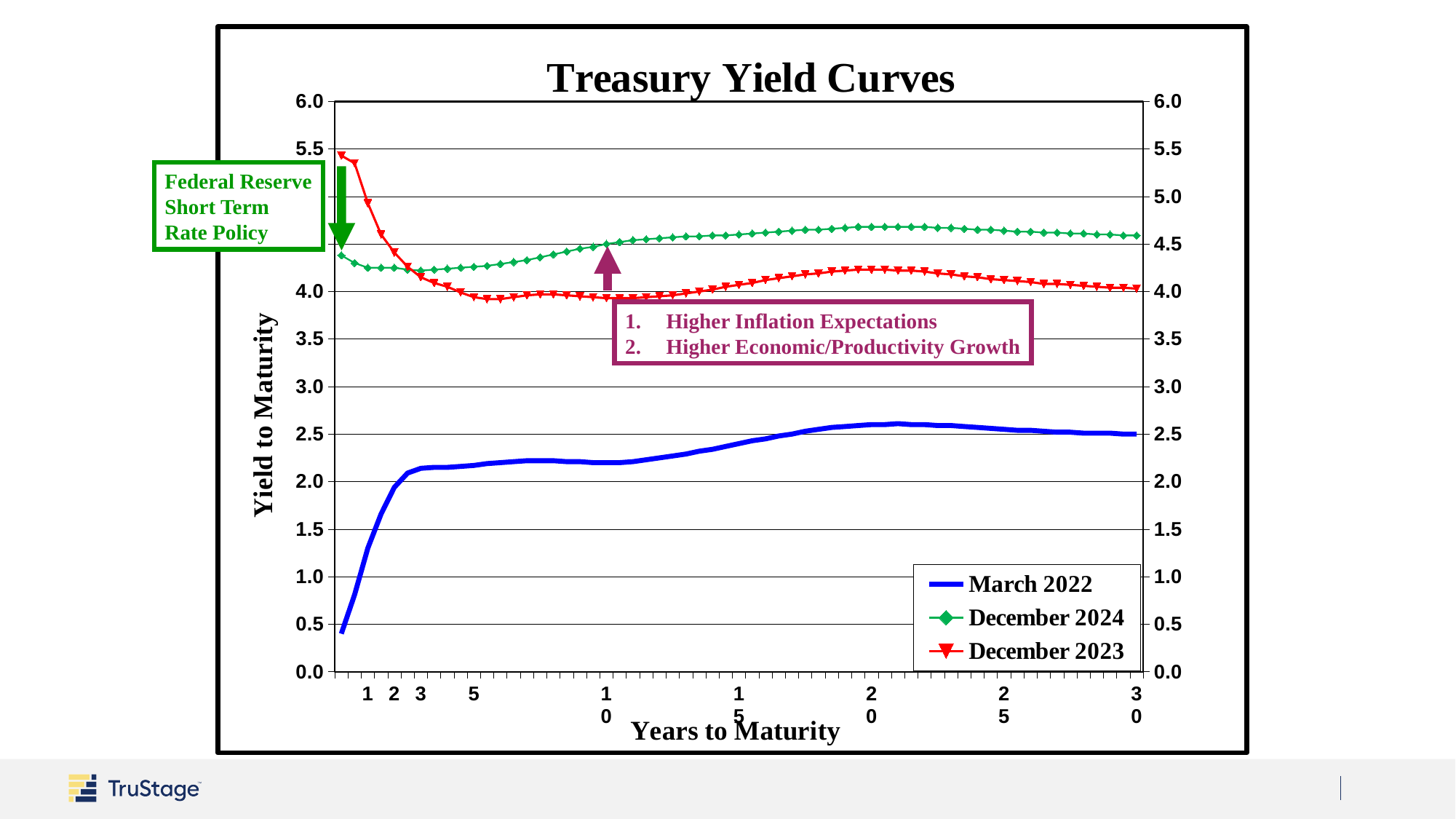
At 1 year to maturity, which is higher: December 2023 or December 2024? December 2023 What is the label of the y axis? Yield to Maturity Which series has the highest yield at the shortest maturity? December 2023 How many series does the legend list? 3 What kind of chart is shown on the slide? line chart Does the December 2023 curve rise or fall between 1 and 5 years to maturity? fall Is the March 2022 yield at 10 years to maturity greater or less than 2.5? less What is the title of the chart? Treasury Yield Curves At 30 years to maturity, which is higher: December 2024 or December 2023? December 2024 Does the March 2022 curve rise or fall between 1 and 10 years to maturity? rise Which series has the lowest yields across all maturities? March 2022